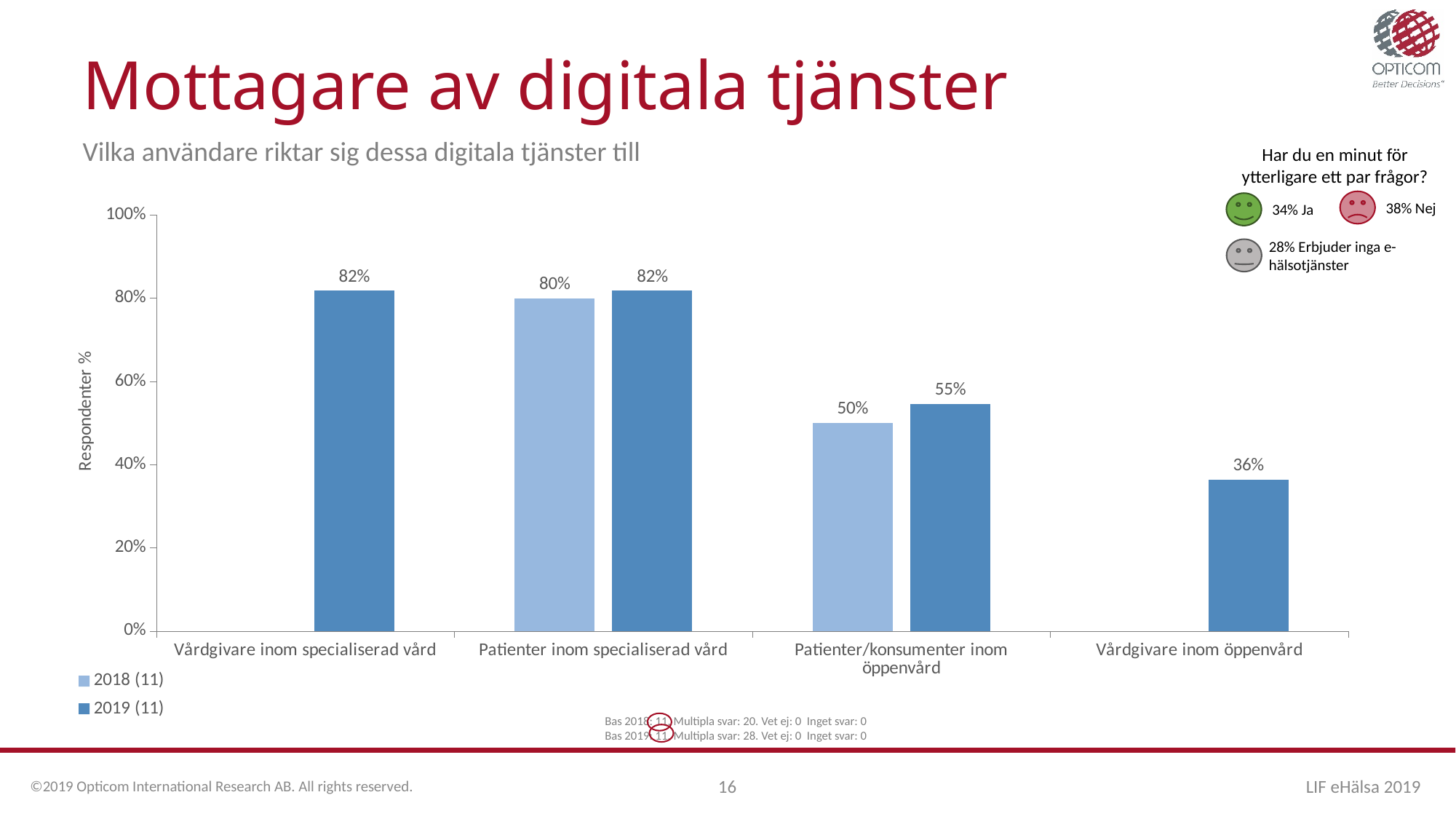
Which category has the highest 2018 value? Patienter inom specialiserad vård What is the 2018 value for Patienter/konsumenter inom öppenvård? 50% What is the difference between the 2019 and 2018 values for Patienter/konsumenter inom öppenvård? 5 percentage points Is the 2019 value for Vårdgivare inom öppenvård greater or less than 40%? less What is the 2019 value for Vårdgivare inom öppenvård? 36% How many categories are shown on the x axis? 4 What is the 2019 value for Patienter/konsumenter inom öppenvård? 55% Which is larger for Patienter inom specialiserad vård: the 2018 value or the 2019 value? 2019 Which category has the lowest 2019 value? Vårdgivare inom öppenvård What kind of chart is shown on the slide? Bar chart How many series does the legend list? 2 What is the 2018 value for Patienter inom specialiserad vård? 80%